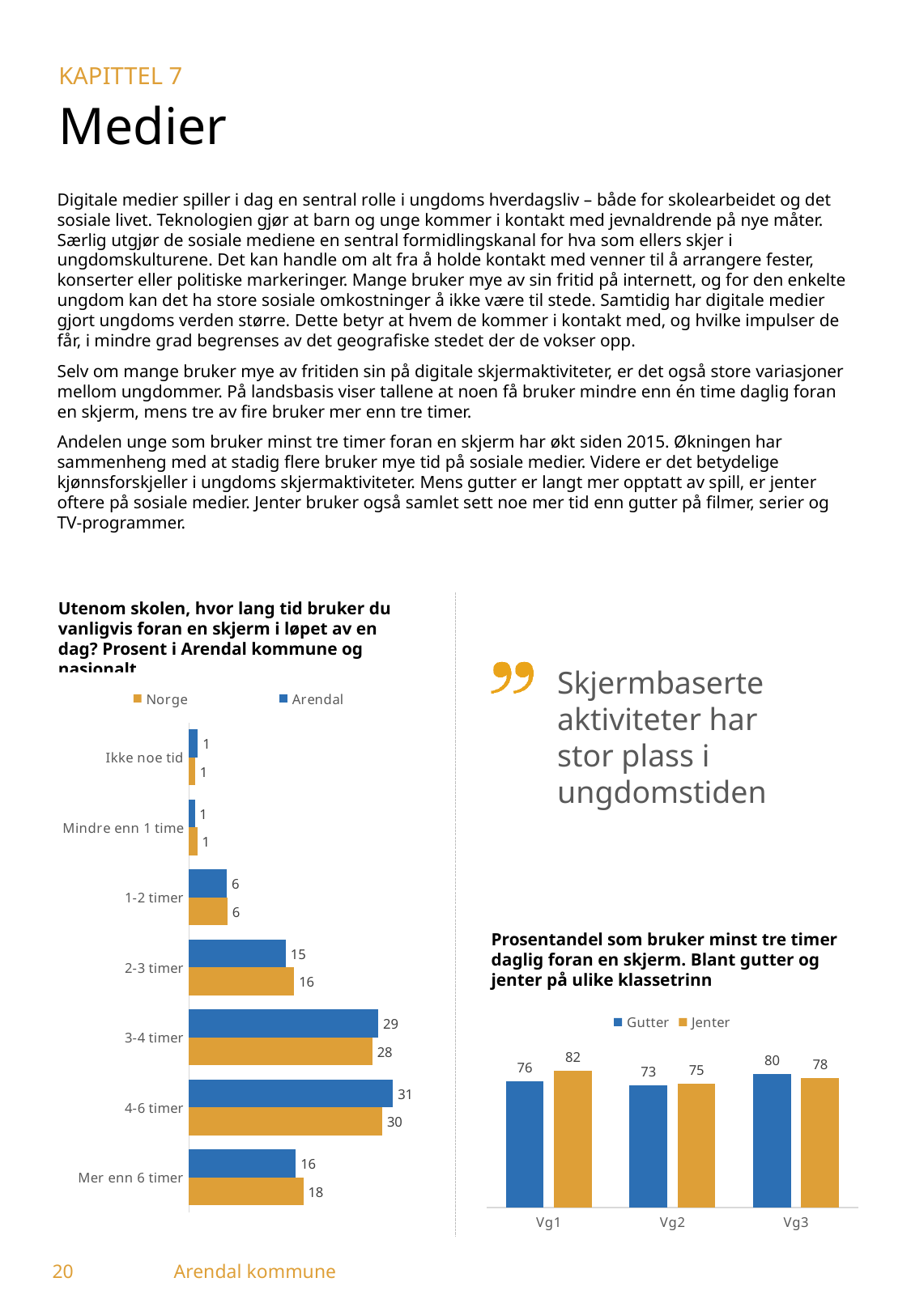
In the right chart (minst tre timer daglig foran en skjerm), which class level has the lowest Gutter value? Vg2 In the right chart (minst tre timer daglig foran en skjerm), what is the difference between the Jenter and Gutter values for Vg1? 6 In the right chart (minst tre timer daglig foran en skjerm), what is the Jenter value for Vg1? 82 In the right chart (minst tre timer daglig foran en skjerm), what is the Gutter value for Vg2? 73 In the left chart (screen time per day), what is the Norge value for 'Mer enn 6 timer'? 18 What type of chart is the right chart (minst tre timer daglig foran en skjerm)? Bar chart In the left chart (screen time per day), which is larger for '2-3 timer': the Arendal value or the Norge value? Norge In the left chart (screen time per day), how many series does the legend list? 2 In the left chart (screen time per day), which category has the highest Arendal value? 4-6 timer In the left chart (screen time per day, Arendal vs. Norge), what is the Arendal value for '4-6 timer'? 31 In the left chart (screen time per day), how many categories are shown on the vertical axis? 7 In the left chart (screen time per day), what is the difference between the Norge and Arendal values for 'Mer enn 6 timer'? 2